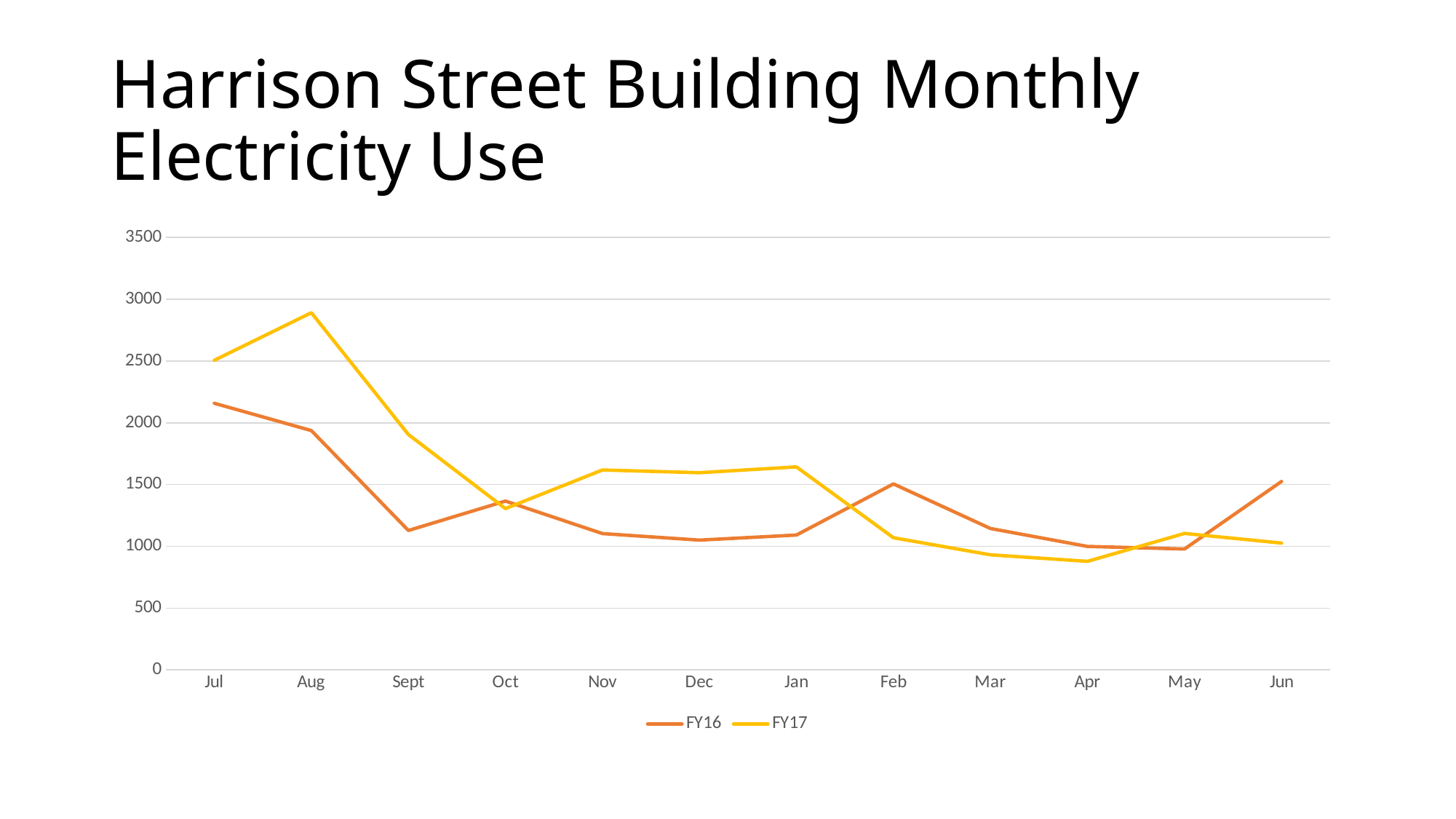
In which month does the FY17 series reach its lowest value? Apr How many series does the legend list? 2 In which month does the FY17 series reach its highest value? Aug In Aug, which series has the larger value, FY16 or FY17? FY17 Does the FY16 series rise or fall from Jul to Sept? fall How many months are plotted along the x axis? 12 Is the FY16 value for Jul greater or less than 2000? greater Is the FY17 value for Aug greater or less than 2500? greater What kind of chart is shown on the slide? line chart In Feb, which series has the larger value, FY16 or FY17? FY16 Is the FY17 value for Apr greater or less than 1000? less In which month does the FY16 series reach its highest value? Jul